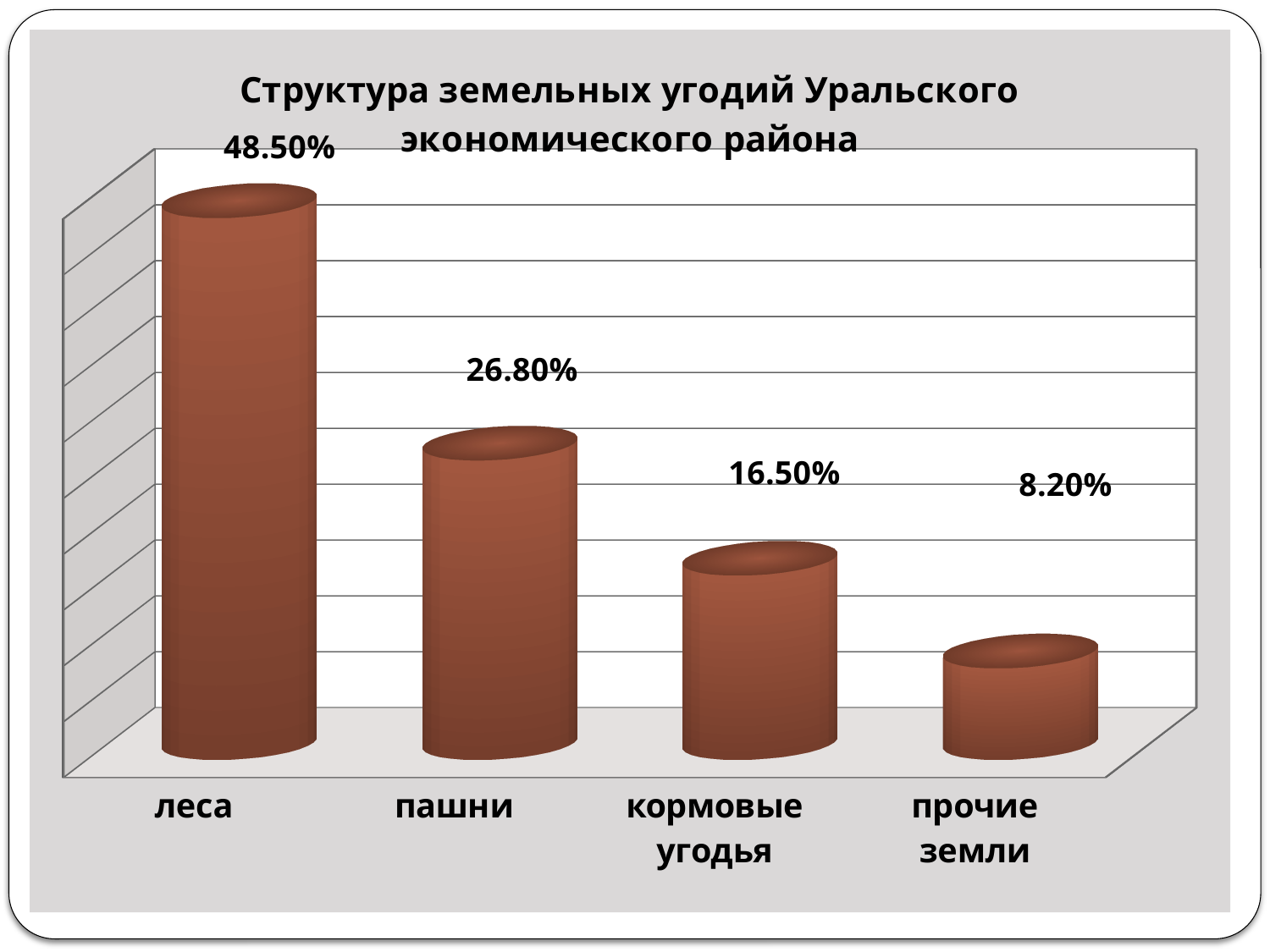
Which category has the lowest value? прочие земли What is the value for пашни? 26.80% What is the difference between the values for леса and пашни? 21.70% How many categories are shown in the chart? 4 What is the title of the chart? Структура земельных угодий Уральского экономического района What is the value for кормовые угодья? 16.50% What is the value for прочие земли? 8.20% What kind of chart is shown on the slide? bar chart Which is larger, the value for пашни or the value for кормовые угодья? пашни What is the value for леса? 48.50% What is the difference between the values for кормовые угодья and прочие земли? 8.30% Which category has the highest value? леса